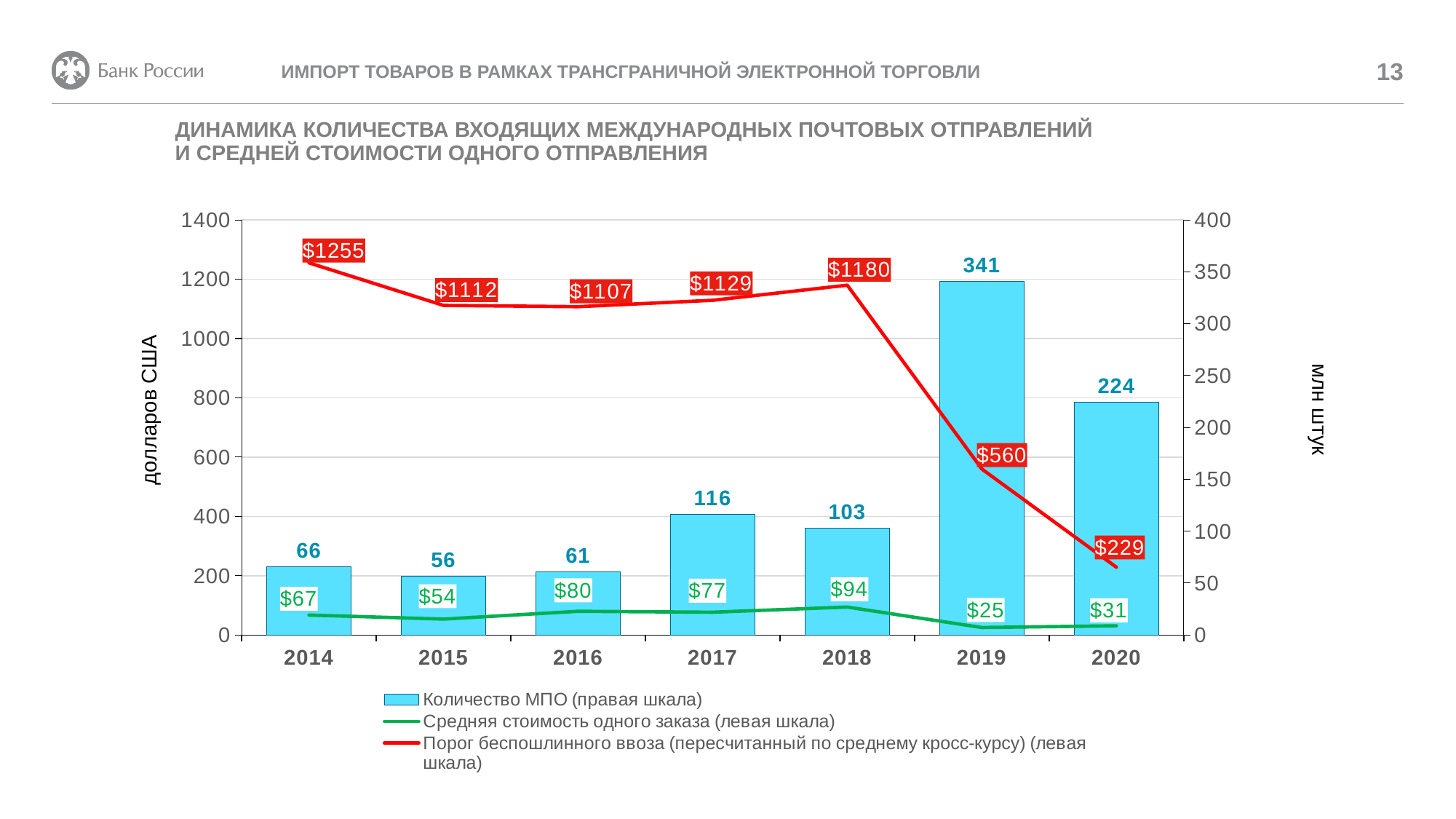
What is the label of the left vertical axis? долларов США Does the Порог беспошлинного ввоза rise or fall from 2018 to 2020? fall How many years are shown on the x axis? 7 What is the Средняя стоимость одного заказа for 2018? $94 Which is larger, the Средняя стоимость одного заказа in 2016 or in 2017? 2016 Which year has the highest Порог беспошлинного ввоза? 2014 Which year has the lowest value of Количество МПО? 2015 What is the value of Количество МПО for 2019? 341 What kind of chart is used for the Количество МПО series? bar chart What is the Порог беспошлинного ввоза value for 2014? $1255 How many series does the legend list? 3 What is the difference between the Количество МПО values for 2019 and 2020? 117